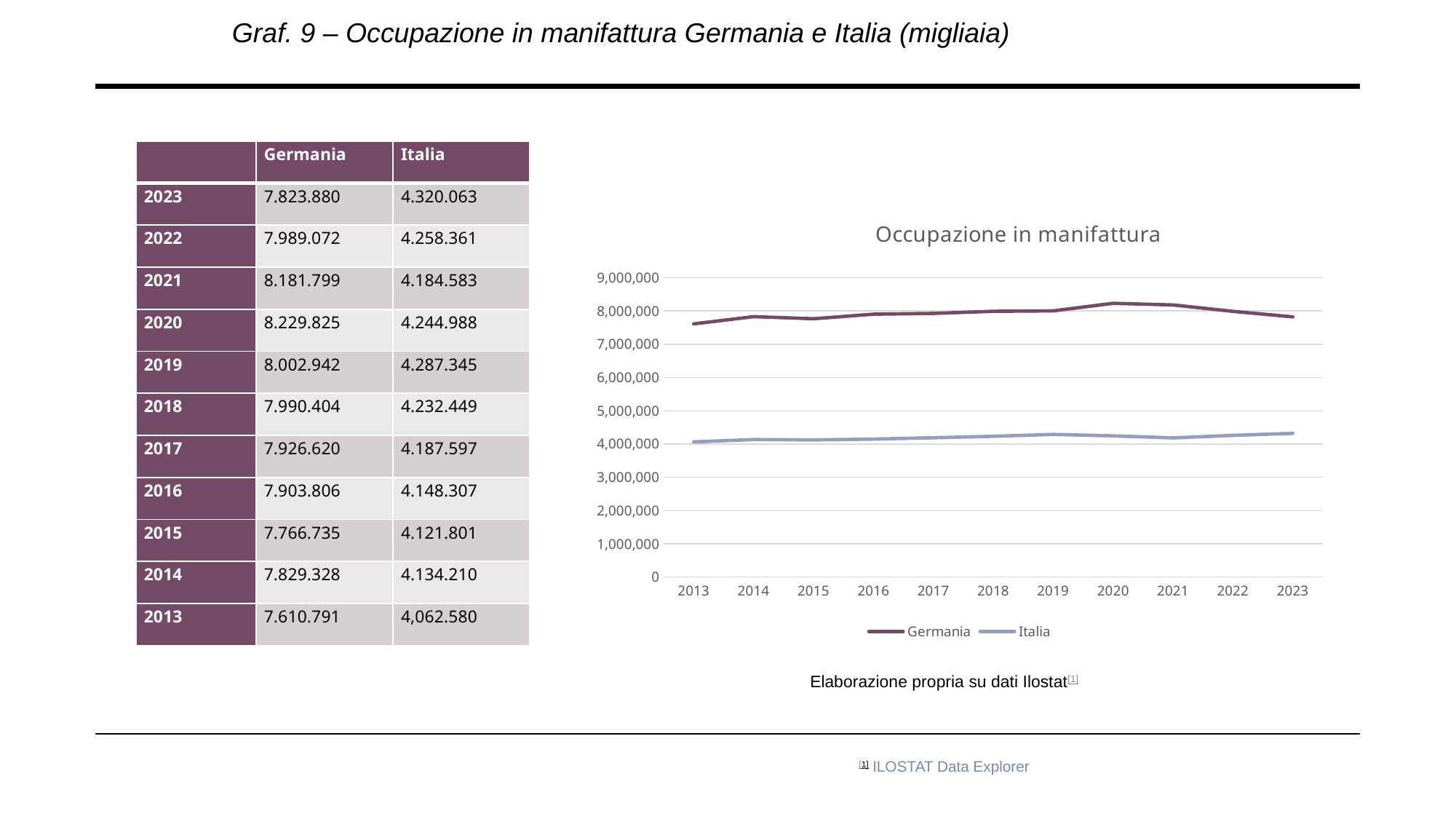
What is the title of the chart? Occupazione in manifattura How many years are plotted along the x axis of the chart? 11 What kind of chart is shown on the slide? line chart In which year does the Germania series have its lowest value? 2013 Is the value for Italia in 2023 greater or less than 5,000,000? less How many series does the legend of the chart list? 2 In which year does the Germania series reach its highest value? 2020 Is the value for Germania in 2021 greater or less than 8,000,000? greater Does the Germania series rise or fall from 2020 to 2023? fall Which series is higher in 2019, Germania or Italia? Germania According to the table, what is the value for Germania in 2023? 7.823.880 According to the table, what is the value for Italia in 2013? 4,062.580